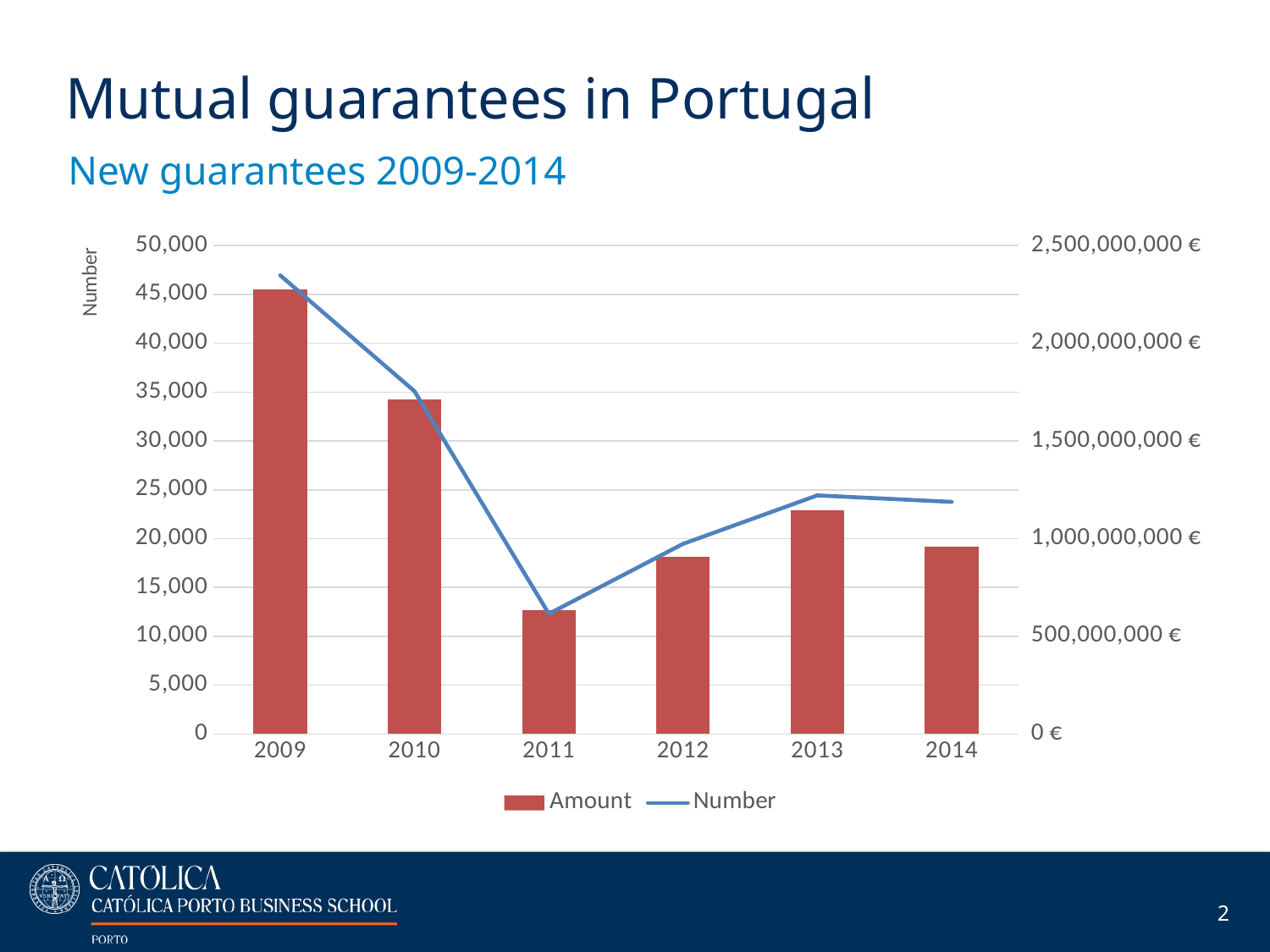
Which year has the larger Amount, 2012 or 2013? 2013 Is the Number for 2011 greater or less than 15,000? less What kind of chart is used for the Amount series? Bar chart How many series does the chart legend list? 2 In which year does the Number line reach its lowest point? 2011 Is the Number for 2010 greater or less than 40,000? less Does the Number line rise or fall from 2009 to 2011? Fall Is the Amount for 2009 greater or less than 2,000,000,000 €? greater In which year is the Amount bar highest? 2009 How many years are shown on the x axis of the chart? 6 In which year is the Amount bar lowest? 2011